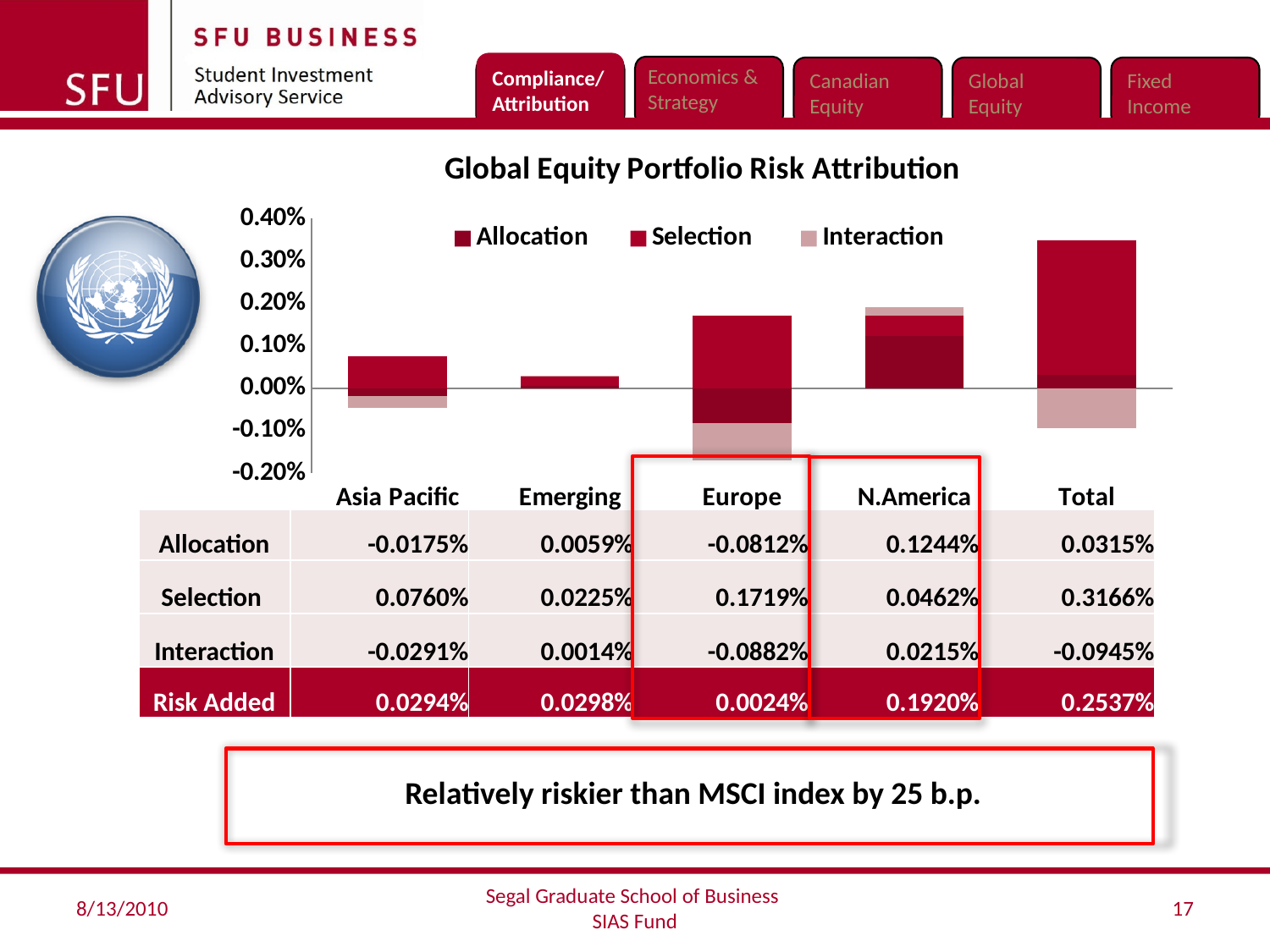
For N.America, which is larger: the Allocation value or the Selection value? Allocation How many categories are shown along the x axis of the chart? 5 What is the total Risk Added for the N.America stacked bar? 0.1920% What kind of chart is shown on the slide? Stacked bar chart What is the difference between the Selection values for Europe and N.America? 0.1257% Which category has the lowest Allocation value? Europe How many series does the chart legend list? 3 What is the title of the chart? Global Equity Portfolio Risk Attribution What is the Allocation value for N.America? 0.1244% What is the Selection value for Europe? 0.1719% What is the Interaction value for Asia Pacific? -0.0291% Which category has the highest Selection value? Total